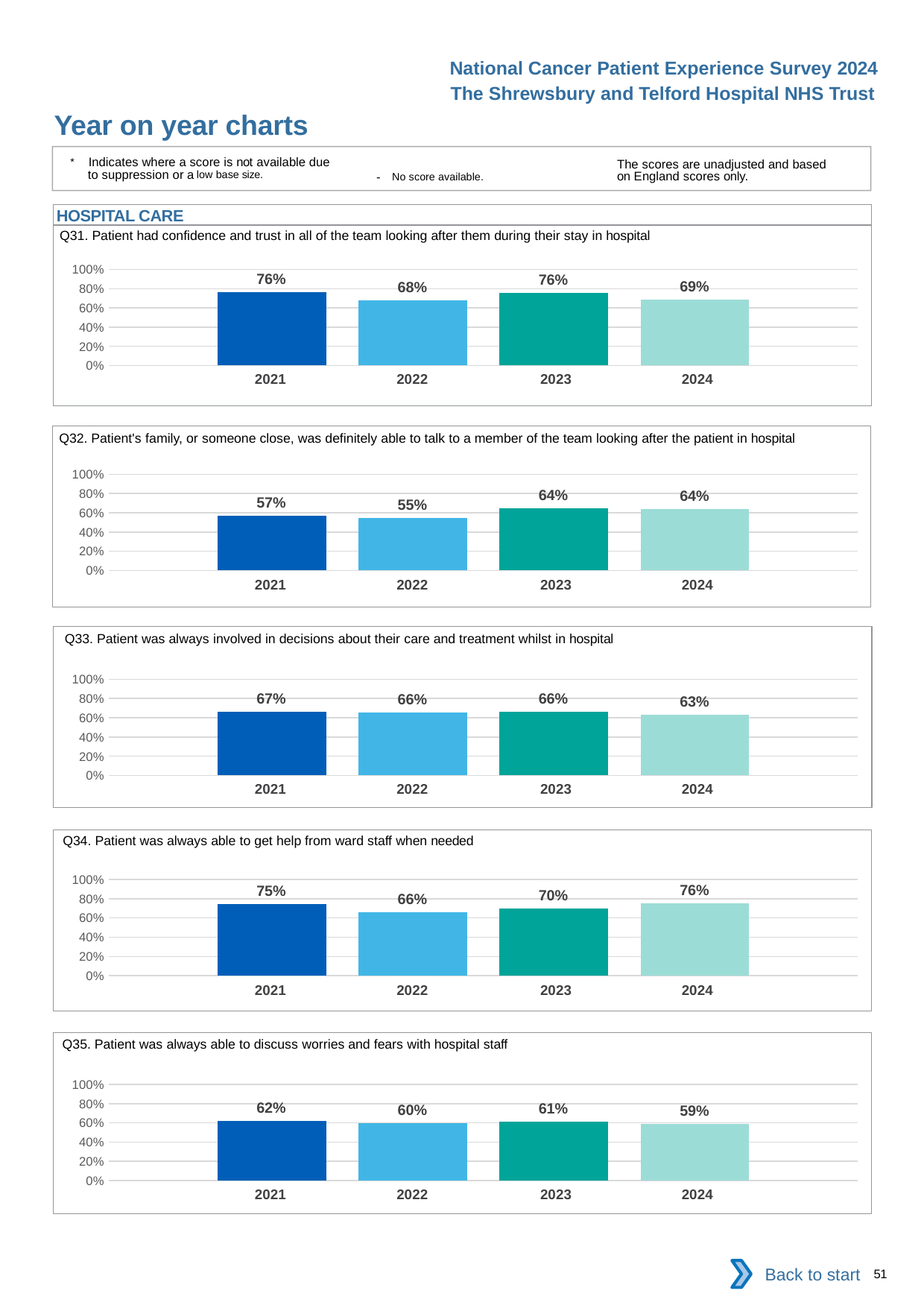
In the Q35 chart (patient was always able to discuss worries and fears), which is larger, the 2021 value or the 2023 value? 2021 In the Q31 chart (patient had confidence and trust in all of the team), what is the value for 2022? 68% How many years are shown on the x axis of the Q33 chart (patient was always involved in decisions about their care)? 4 In the Q35 chart (patient was always able to discuss worries and fears), is the value for 2022 greater or less than 80%? less In the Q31 chart (patient had confidence and trust in all of the team), what is the difference between the 2023 and 2024 values? 7% In the Q34 chart (patient was always able to get help from ward staff), which year has the lowest value? 2022 In the Q33 chart (patient was always involved in decisions about their care), which year has the highest value? 2021 In the Q35 chart (patient was always able to discuss worries and fears), what is the value for 2024? 59% What kind of chart is the Q34 chart (patient was always able to get help from ward staff)? Bar chart In the Q32 chart (patient's family was definitely able to talk to a member of the team), which year has the lowest value? 2022 In the Q34 chart (patient was always able to get help from ward staff), what is the difference between the 2024 and 2022 values? 10% In the Q32 chart (patient's family was definitely able to talk to a member of the team), what is the value for 2021? 57%